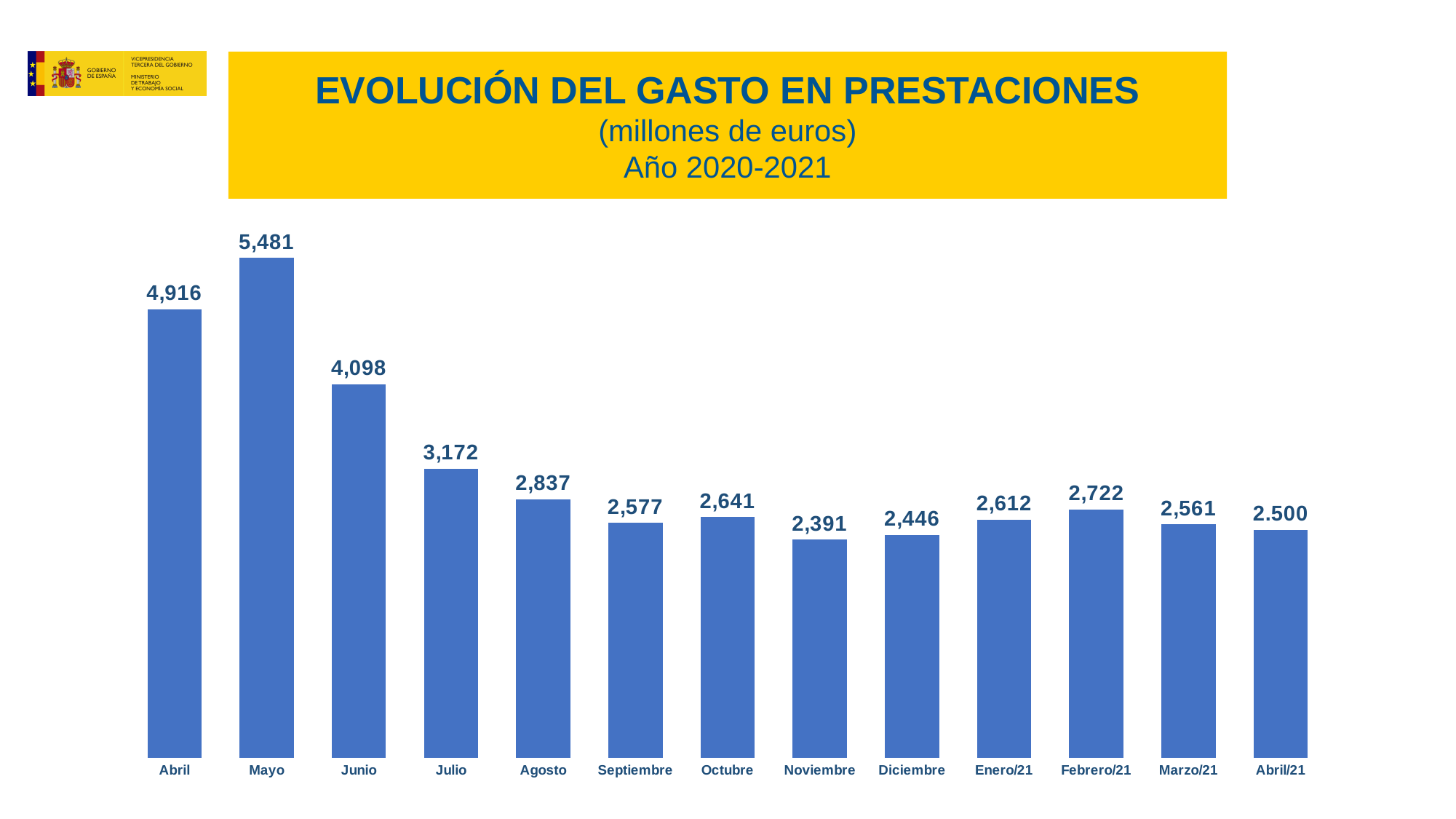
What kind of chart is shown on the slide? Bar chart Which is larger, the value for Octubre or the value for Septiembre? Octubre Which month has the lowest value? Noviembre Do the values rise or fall from Mayo to Julio? Fall What is the value for Mayo? 5,481 What is the difference between the values for Mayo and Abril? 565 Which month has the highest value? Mayo What is the difference between the values for Junio and Julio? 926 How many months are shown on the chart? 13 What is the value for Abril/21? 2.500 Which is larger, the value for Febrero/21 or the value for Marzo/21? Febrero/21 What is the value for Noviembre? 2,391